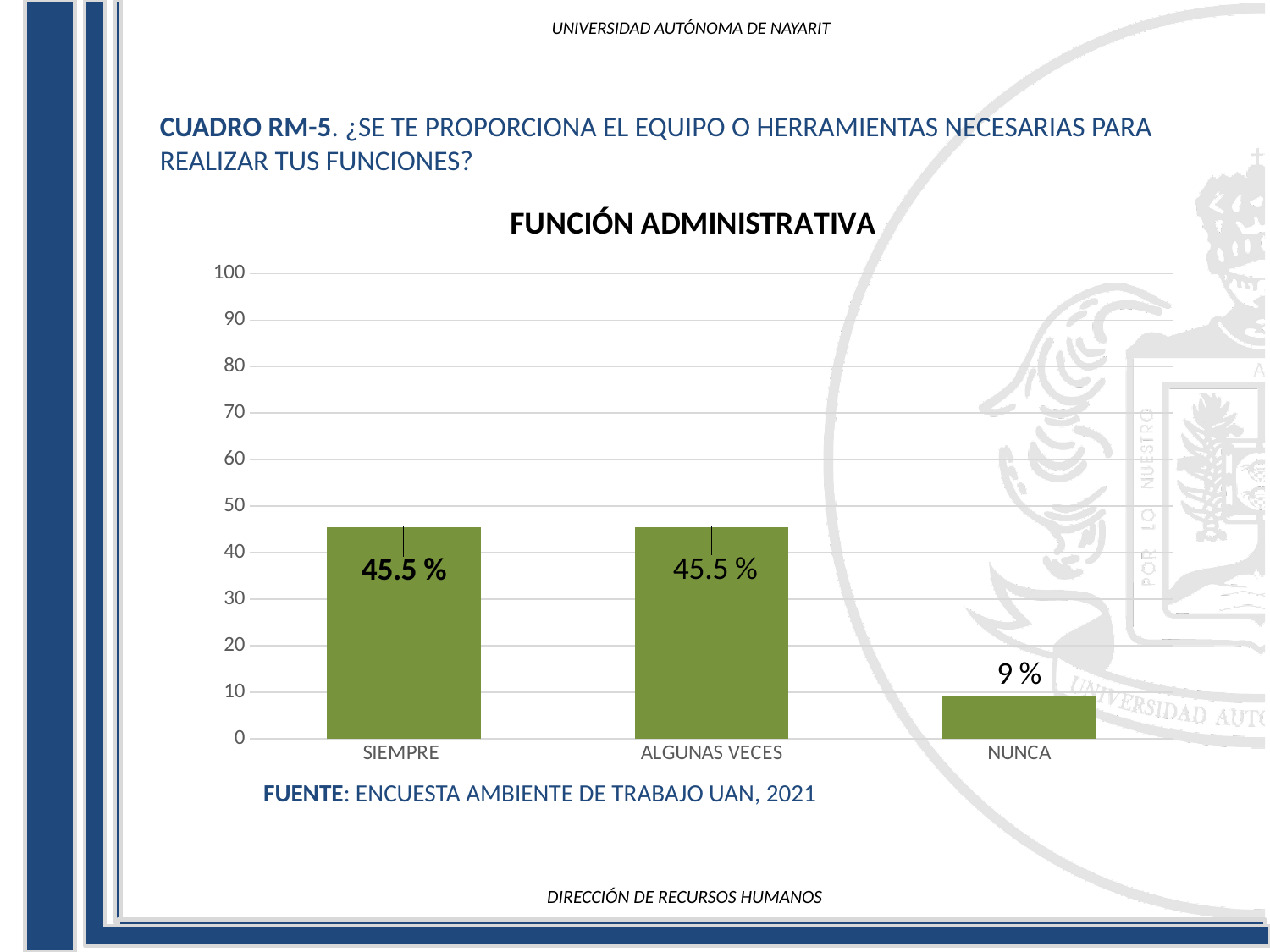
Which is larger, the value for SIEMPRE or the value for NUNCA? SIEMPRE What is the title of the chart? FUNCIÓN ADMINISTRATIVA Which category has the lowest value? NUNCA What kind of chart is shown on the slide? bar chart Is the value for SIEMPRE greater or less than 40? greater What is the difference between the value for ALGUNAS VECES and the value for NUNCA? 36.5 % What is the value for ALGUNAS VECES? 45.5 % What is the value for NUNCA? 9 % What is the highest value shown on the y axis? 100 Is the value for NUNCA greater or less than 20? less What is the value for SIEMPRE? 45.5 % How many categories are shown on the x axis? 3